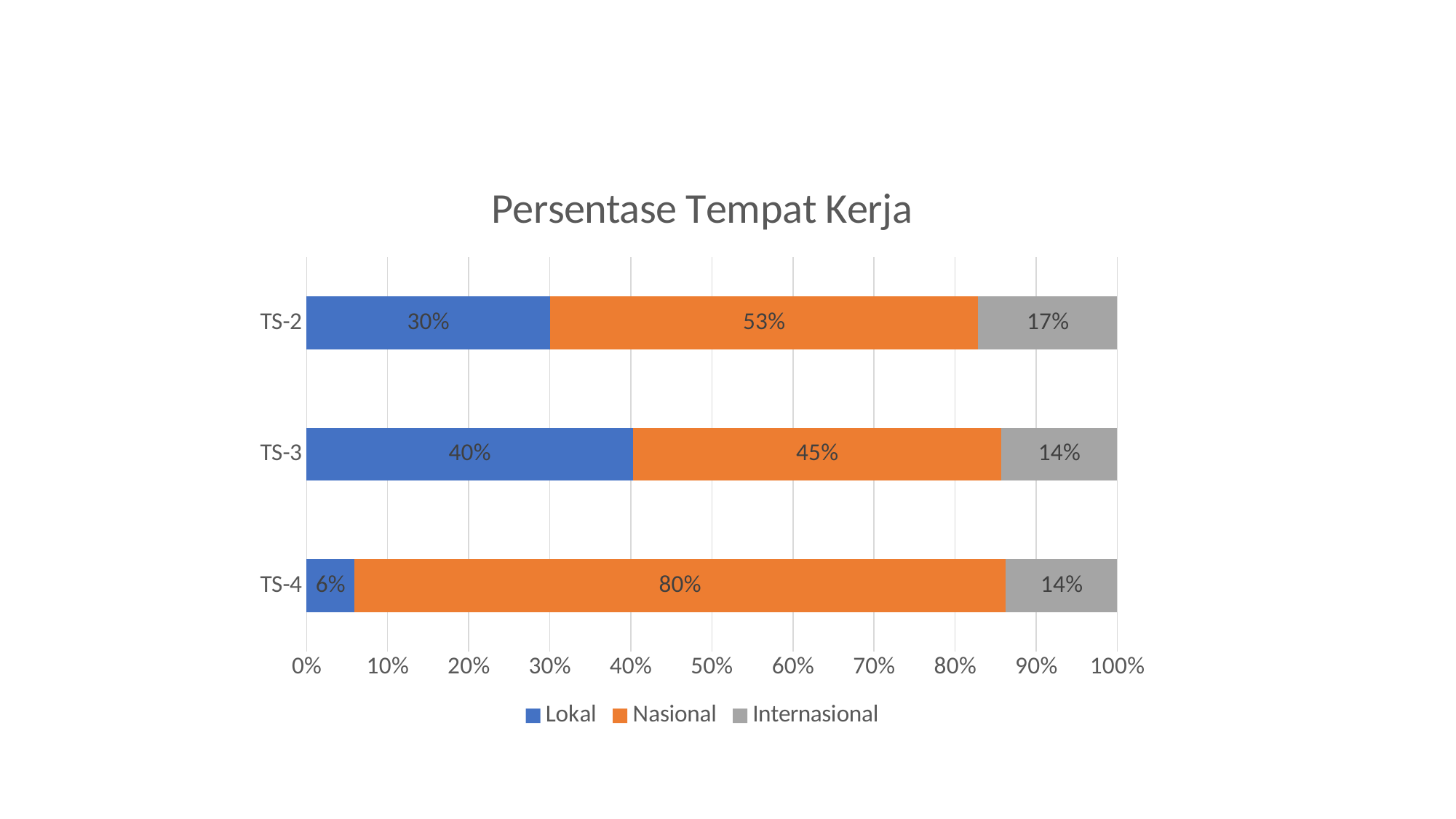
Which is larger, the Lokal value for TS-2 or the Lokal value for TS-3? TS-3 How many series does the legend list? 3 How many categories are shown on the y axis? 3 What is the Internasional value for TS-2? 17% What is the Lokal value for TS-3? 40% Which category has the highest Nasional value? TS-4 What is the total of the stacked bar for TS-2? 100% What is the Nasional value for TS-4? 80% What kind of chart is shown? Stacked bar chart What is the title of the chart? Persentase Tempat Kerja What is the difference between the Nasional values for TS-4 and TS-3? 35% Which category has the lowest Lokal value? TS-4